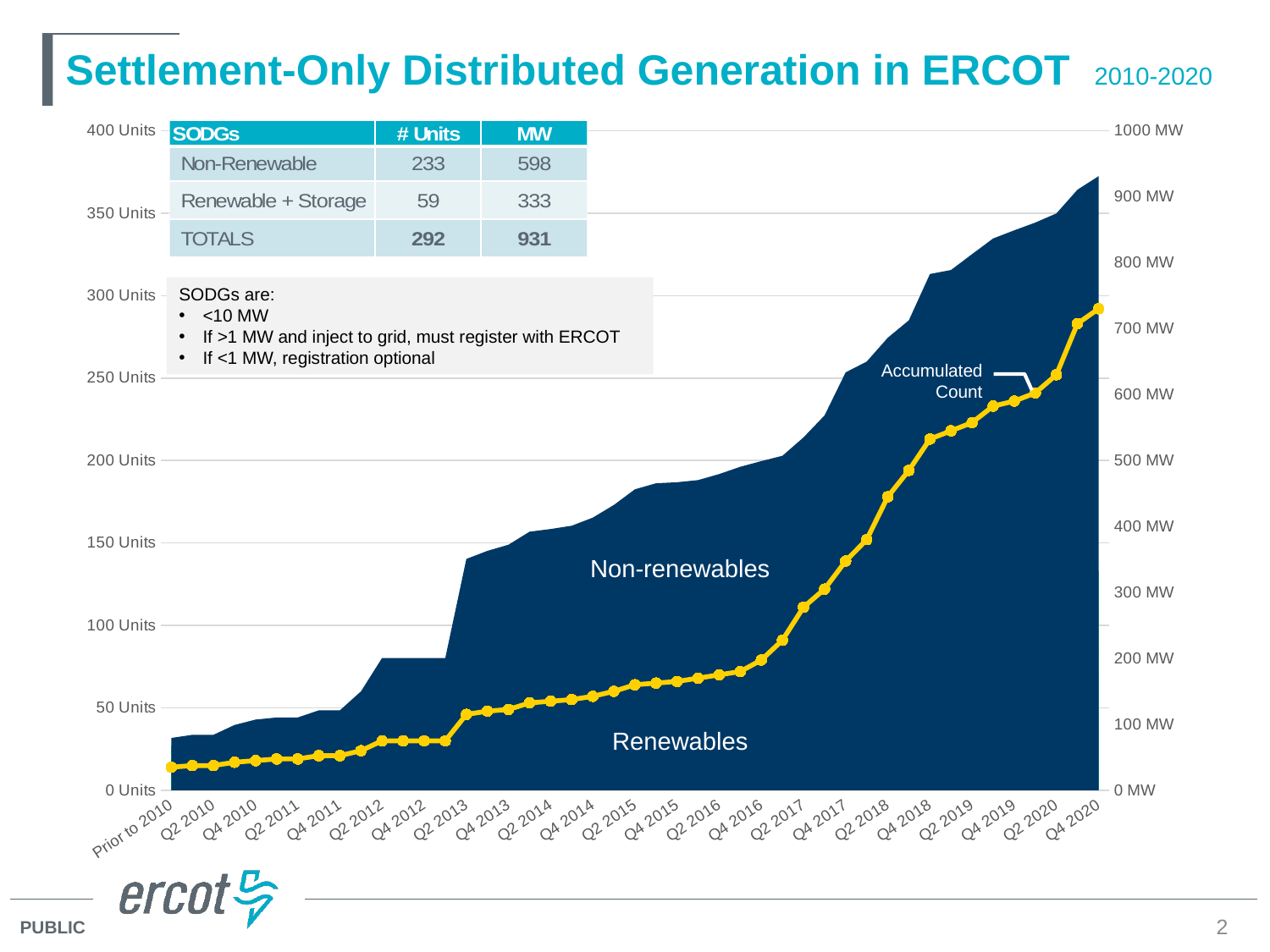
Is the Accumulated Count at Q4 2016 greater or less than 100 Units? less At Q4 2020, which area is larger, Non-renewables or Renewables? Non-renewables At which x-axis point is the Accumulated Count highest? Q4 2020 At which x-axis point is the Accumulated Count lowest? Prior to 2010 What does the yellow line on the chart represent? Accumulated Count What kind of chart is shown on the slide? Stacked area chart with a line Is the total MW (top of the stacked area) at Q4 2020 greater or less than 900 MW? greater Is the Accumulated Count at Q4 2018 greater or less than 200 Units? greater What is the title of the chart on the slide? Settlement-Only Distributed Generation in ERCOT How many data series are plotted on the chart (areas plus line)? 3 Does the Accumulated Count line rise or fall from Prior to 2010 to Q4 2020? Rise